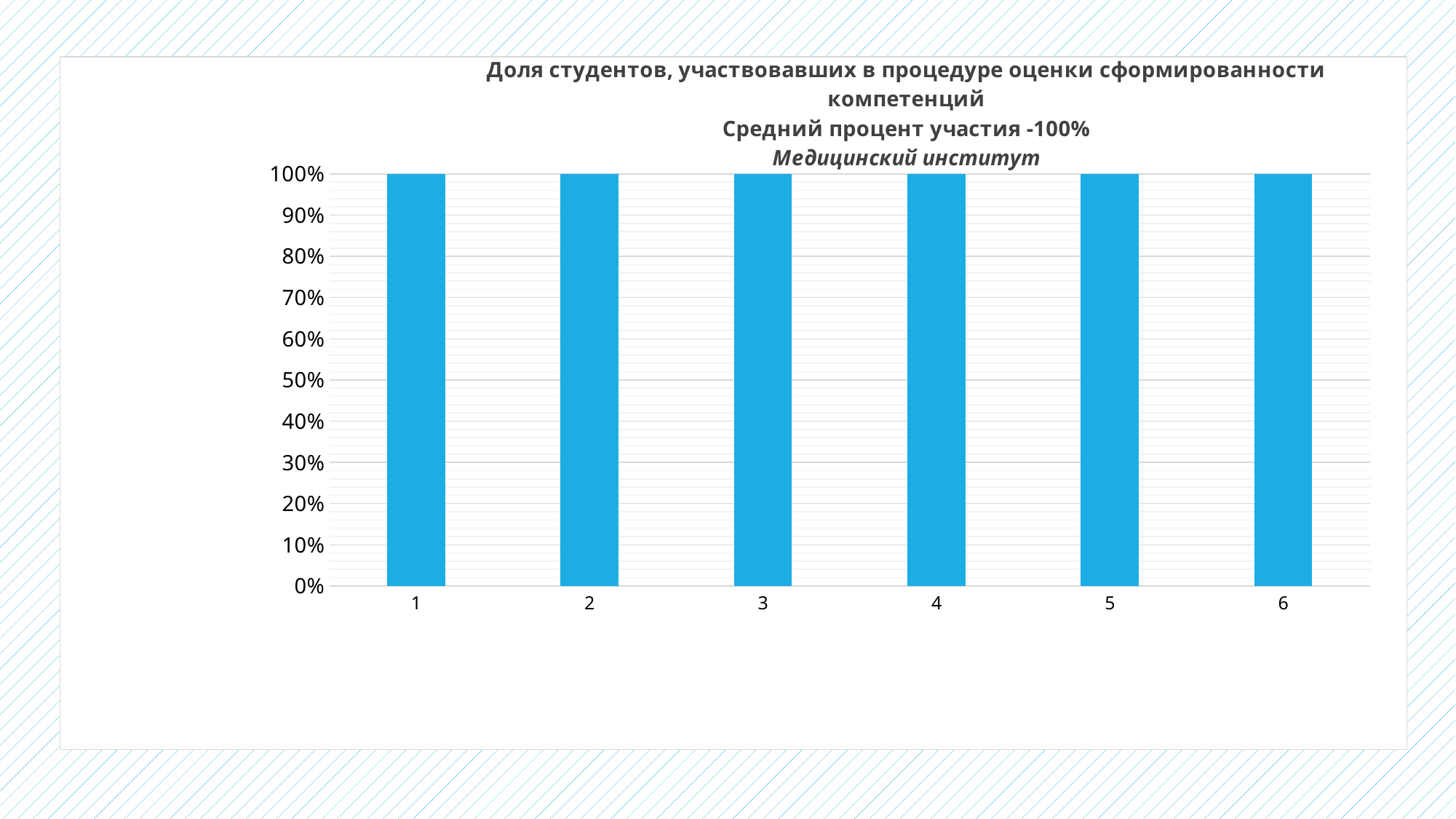
Is the value for category 3 greater or less than 50%? greater What is the difference between the values for category 2 and category 5? 0% How many bars (categories) are plotted in the chart? 6 What is the value for category 6? 100% What is the highest value shown on the vertical axis? 100% What is the value for category 1? 100% What kind of chart is shown on the slide? bar chart Is the value for category 5 greater or less than 90%? greater What is the value for category 4? 100% Do the values rise, fall, or stay the same from category 1 to category 6? stay the same What institute is named in the chart title? Медицинский институт